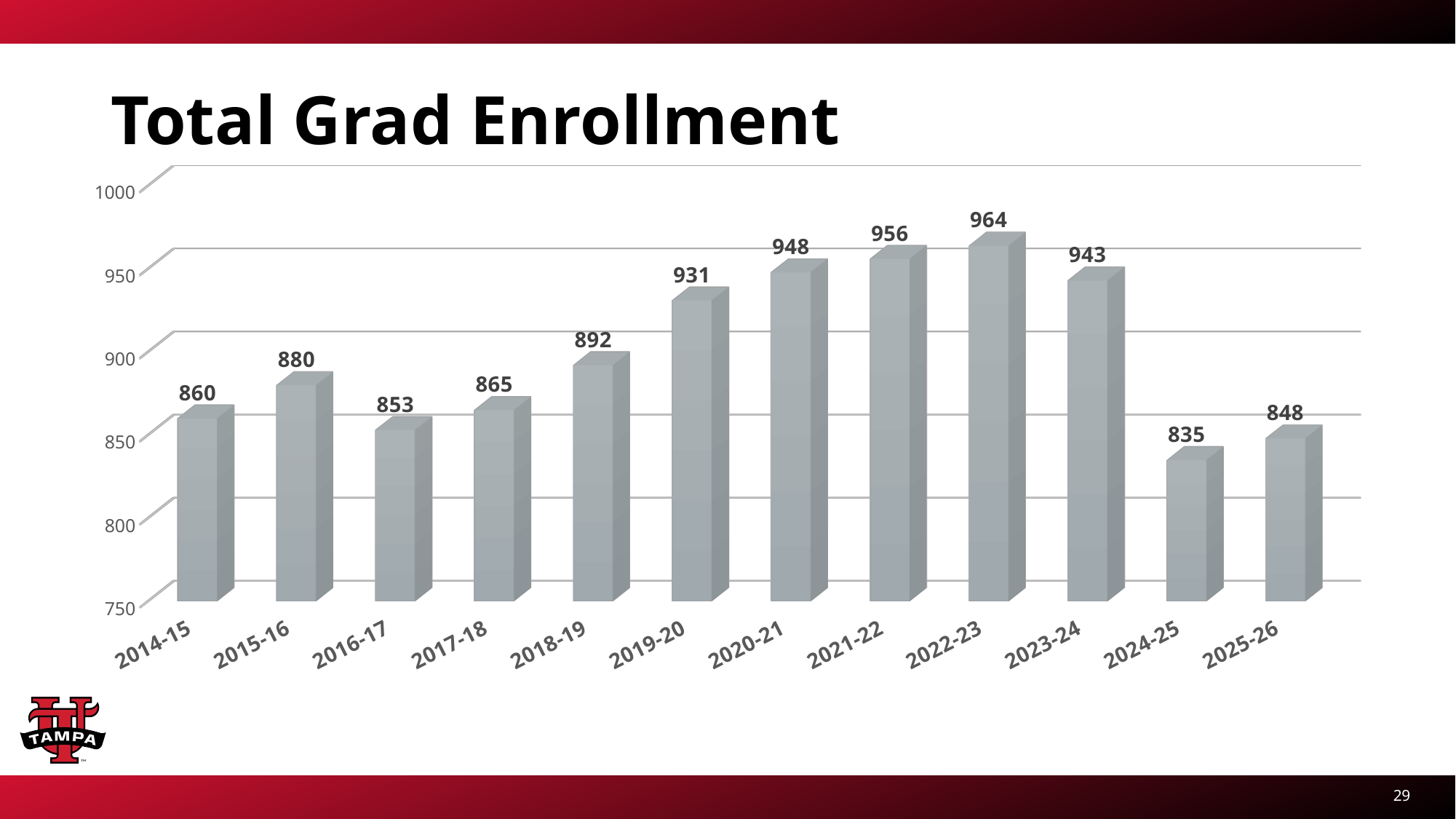
What is the total grad enrollment for 2024-25? 835 Is the total grad enrollment for 2020-21 greater or less than 900? greater What is the total grad enrollment for 2019-20? 931 What is the total grad enrollment for 2014-15? 860 What is the title of the chart? Total Grad Enrollment What kind of chart is shown on the slide? Bar chart Which academic year has the lowest total grad enrollment? 2024-25 Which academic year has the highest total grad enrollment? 2022-23 Which year has a higher total grad enrollment, 2015-16 or 2017-18? 2015-16 How many academic years are shown on the chart? 12 What is the difference in total grad enrollment between 2022-23 and 2024-25? 129 What is the difference in total grad enrollment between 2025-26 and 2024-25? 13